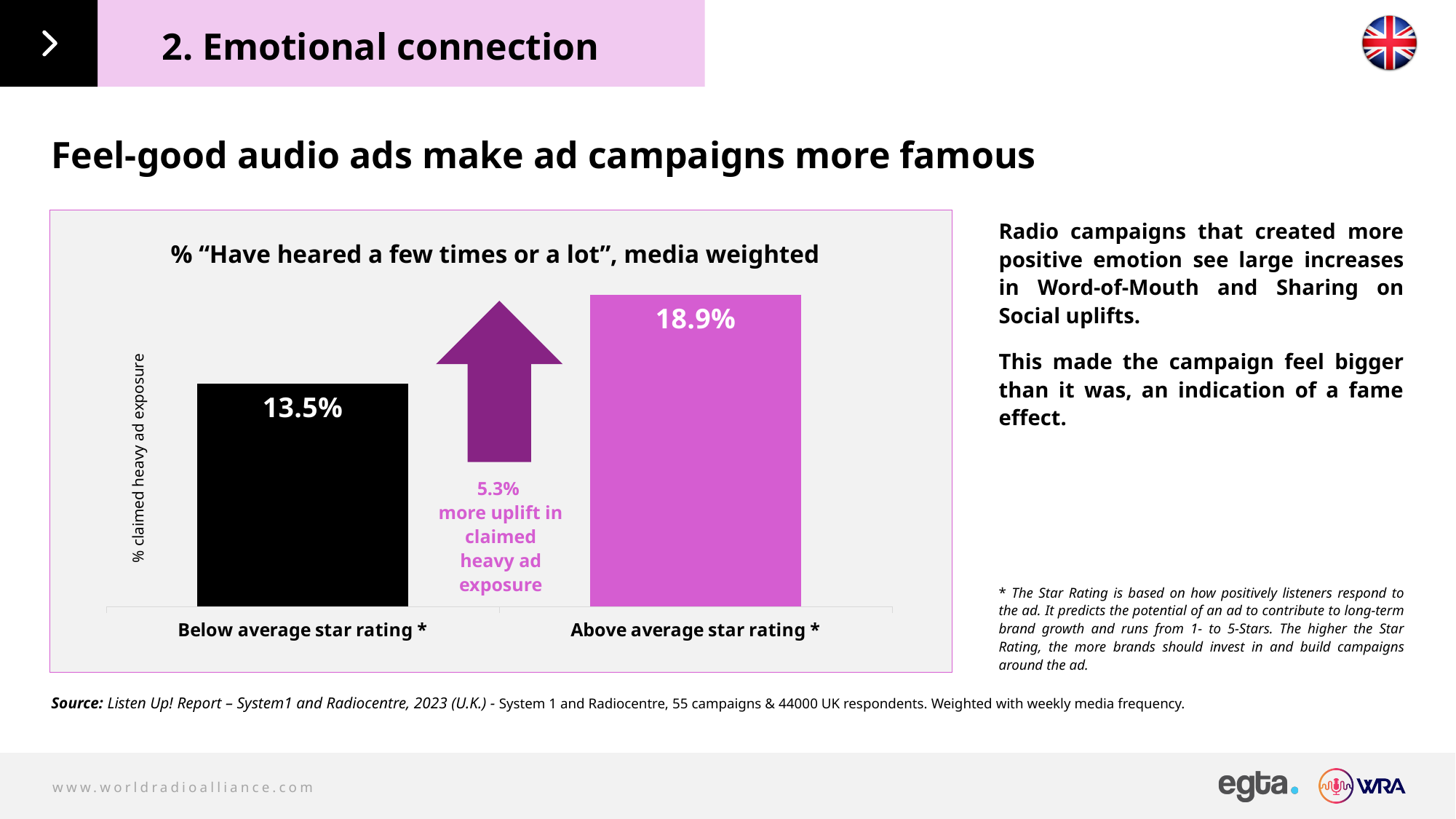
What kind of chart is shown on the slide? Bar chart What is the value for "Below average star rating"? 13.5% What is the label on the vertical axis of the chart? % claimed heavy ad exposure Which is larger: the value for "Below average star rating" or "Above average star rating"? Above average star rating Which category has the lowest value? Below average star rating What uplift in claimed heavy ad exposure is annotated between the two bars? 5.3% What is the value for "Above average star rating"? 18.9% How many categories are shown in the chart? 2 Which category has the highest value? Above average star rating What is the difference between the values for "Above average star rating" and "Below average star rating"? 5.4% What is the title of the chart? % "Have heared a few times or a lot", media weighted